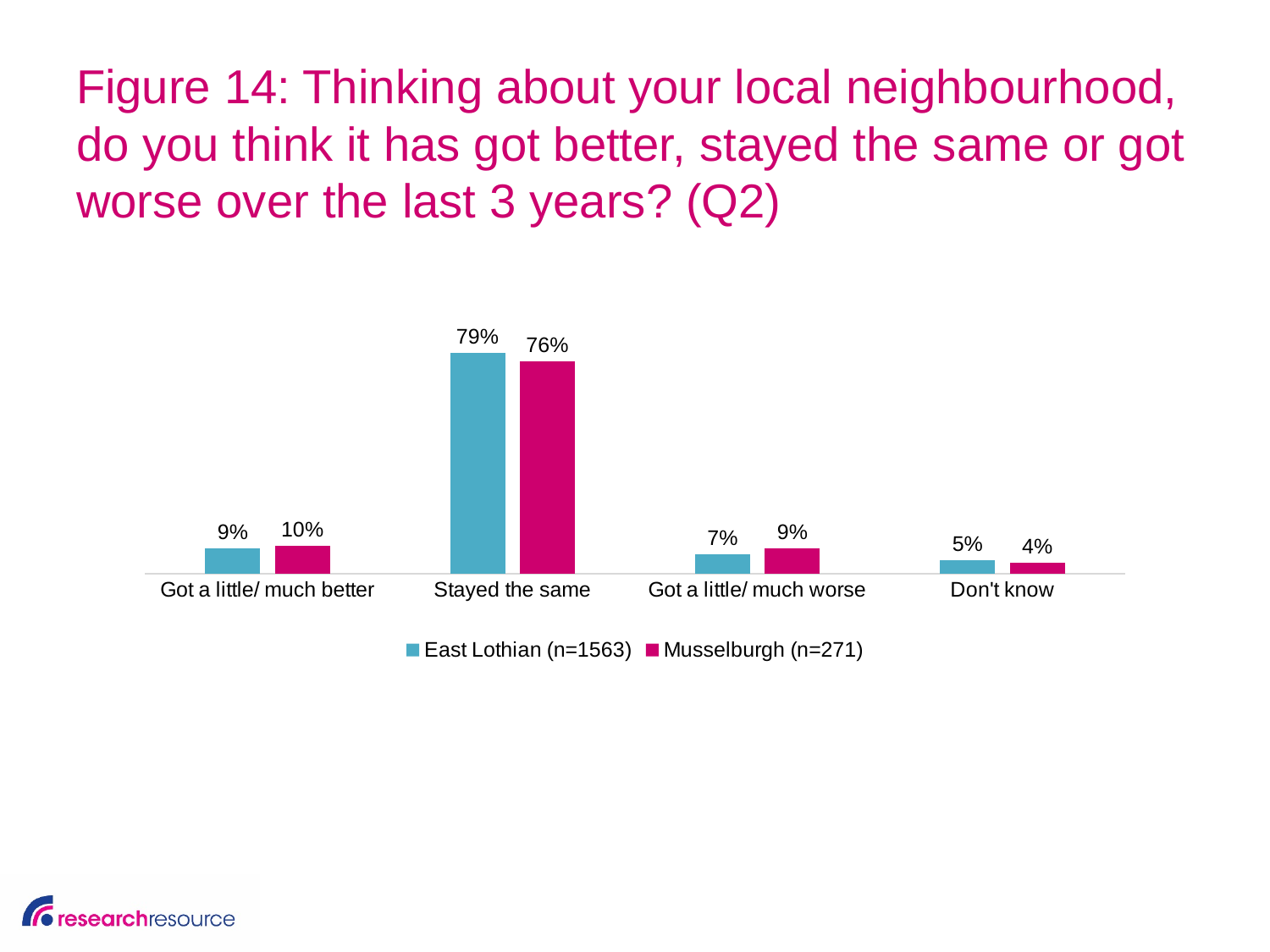
Which category has the lowest value for East Lothian? Don't know Which is larger for 'Got a little/ much better': East Lothian or Musselburgh? Musselburgh How many series does the legend list? 2 What percentage of East Lothian respondents said their neighbourhood stayed the same? 79% What is the value for Musselburgh in the 'Don't know' category? 4% Which colour represents East Lothian in the chart? Blue What percentage of Musselburgh respondents said their neighbourhood got a little/much worse? 9% How many response categories are shown on the x axis? 4 Which category has the highest value for Musselburgh? Stayed the same What is the sample size for Musselburgh shown in the legend? n=271 What kind of chart is shown on the slide? Bar chart What is the difference between the East Lothian and Musselburgh values for 'Stayed the same'? 3%